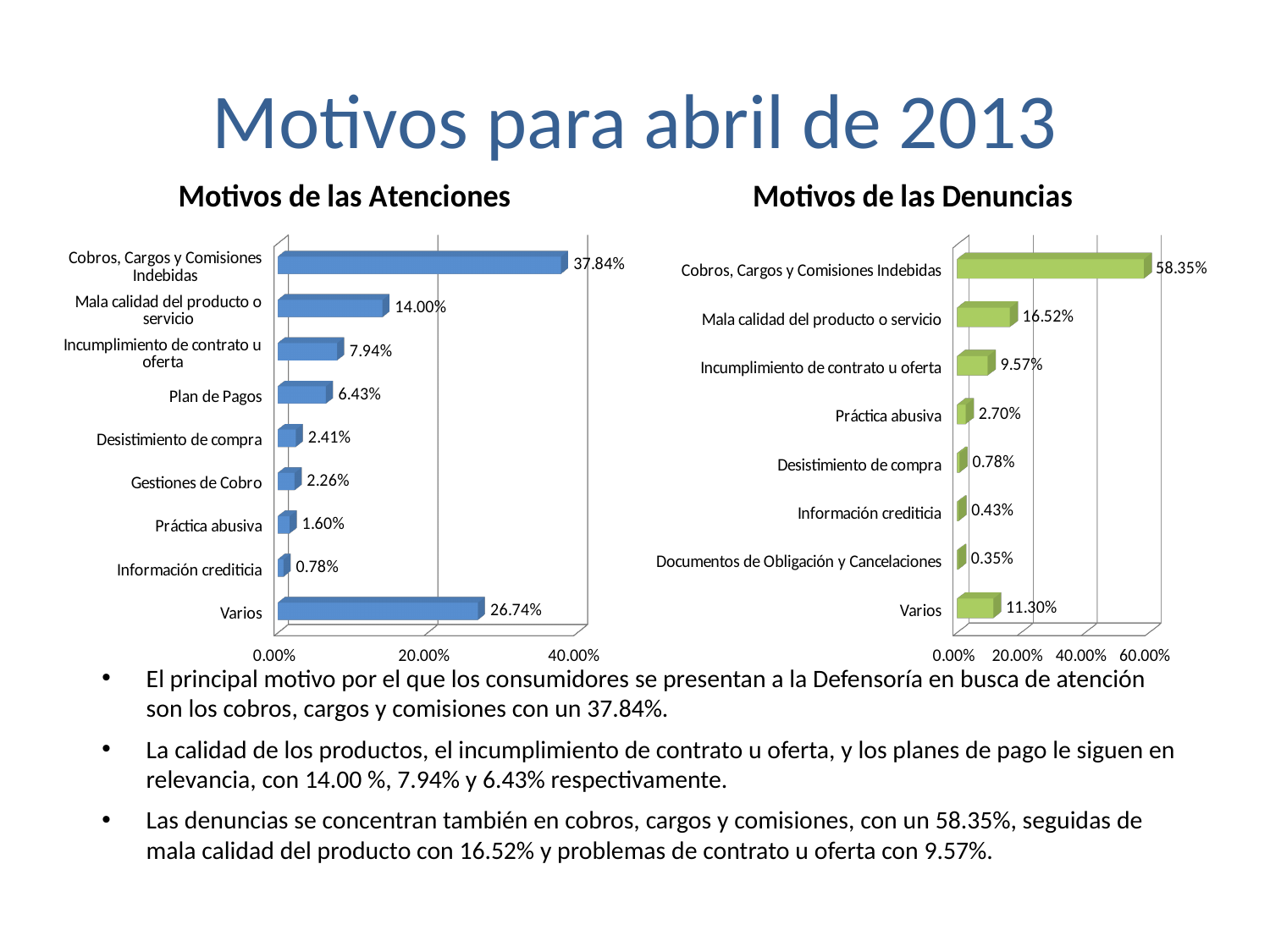
In the 'Motivos de las Atenciones' chart, which category has the lowest value? Información crediticia In the 'Motivos de las Denuncias' chart, which category has the lowest value? Documentos de Obligación y Cancelaciones In the 'Motivos de las Denuncias' chart, which category has the highest value? Cobros, Cargos y Comisiones Indebidas In the 'Motivos de las Denuncias' chart, what is the difference between Incumplimiento de contrato u oferta and Práctica abusiva? 6.87% In the 'Motivos de las Denuncias' chart, what is the value for Varios? 11.30% In the 'Motivos de las Atenciones' chart, which is larger: Desistimiento de compra or Práctica abusiva? Desistimiento de compra In the 'Motivos de las Atenciones' chart, what is the difference between Cobros, Cargos y Comisiones Indebidas and Varios? 11.10% In the 'Motivos de las Atenciones' chart, what is the value for Cobros, Cargos y Comisiones Indebidas? 37.84% What type of chart is the 'Motivos de las Atenciones' chart? Bar chart In the 'Motivos de las Denuncias' chart, what is the value for Mala calidad del producto o servicio? 16.52% How many categories are shown in the 'Motivos de las Denuncias' chart? 8 In the 'Motivos de las Atenciones' chart, what is the value for Plan de Pagos? 6.43%